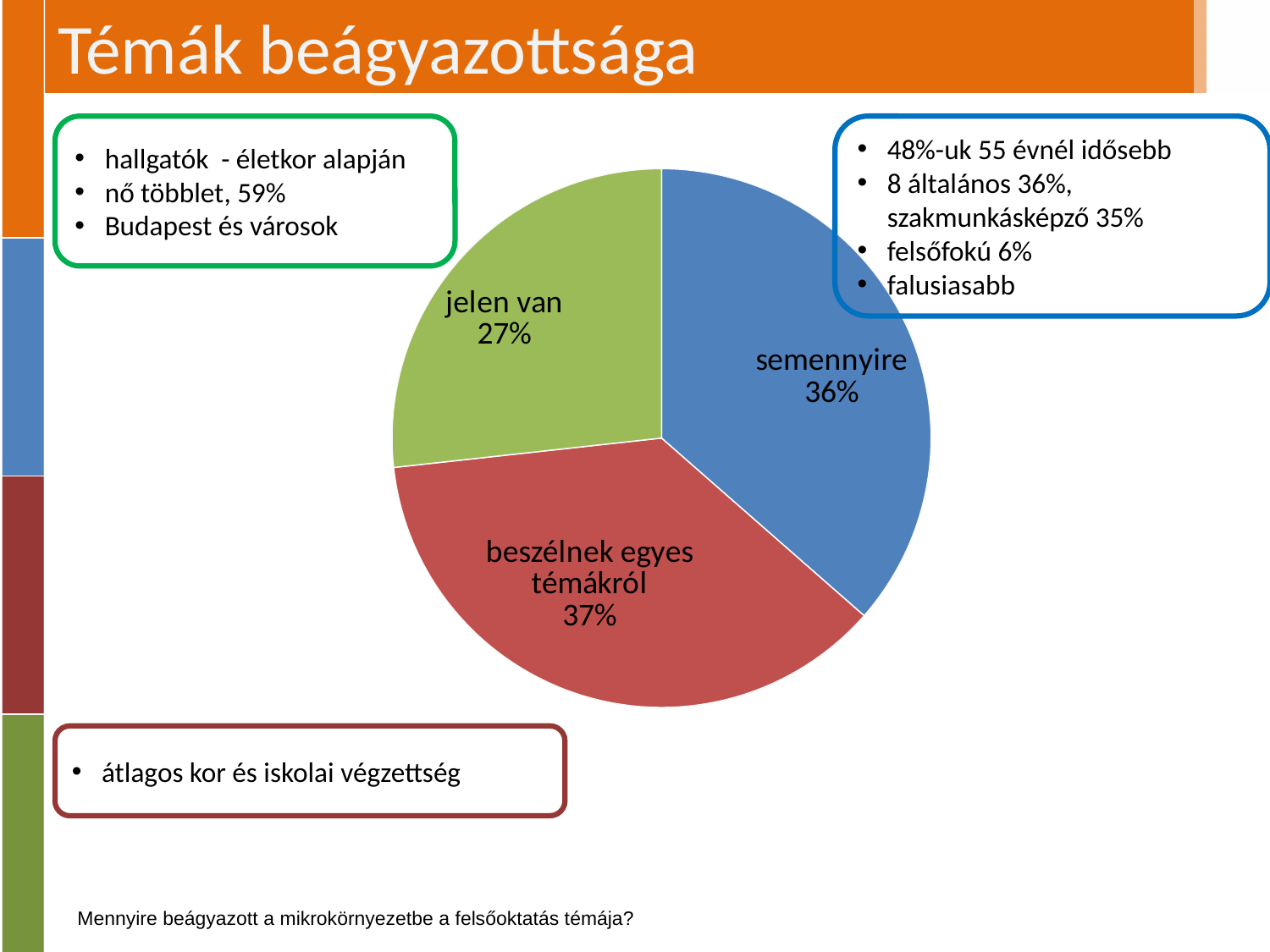
What colour is the "jelen van" slice of the pie chart? green Which slice of the pie chart is the largest according to the printed labels? beszélnek egyes témákról What is the value shown for the "beszélnek egyes témákról" slice? 37% What share does the "jelen van" slice have in the pie chart? 27% What is the combined share of the "semennyire" and "jelen van" slices? 63% How many percentage points larger is "beszélnek egyes témákról" than "jelen van"? 10 What colour is the "semennyire" slice of the pie chart? blue What percentage of the pie chart is labelled "semennyire"? 36% What type of chart is shown on the slide? pie chart How many slices does the pie chart have? 3 Which slice of the pie chart is the smallest? jelen van Which slice is larger: "semennyire" or "jelen van"? semennyire